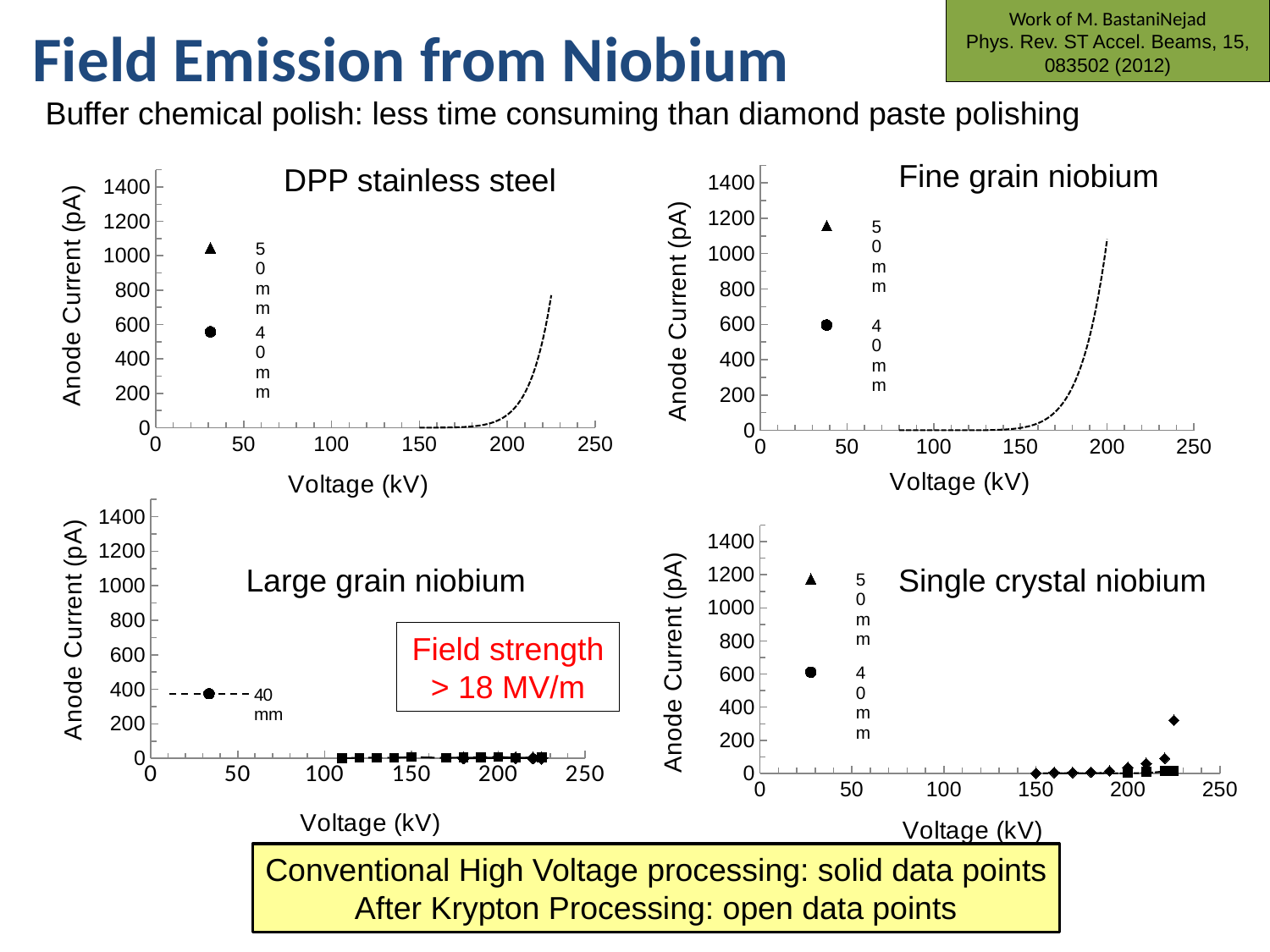
What is the y-axis label of the 'Fine grain niobium' chart? Anode Current (pA) In the 'DPP stainless steel' chart, how many series does the legend list? 2 What is the maximum value shown on the y-axis of the 'Single crystal niobium' chart? 1400 In the 'Single crystal niobium' chart, is the highest plotted anode current greater or less than 400 pA? less How many charts are shown on the slide? 4 In the 'Large grain niobium' chart, is the anode current at 200 kV greater or less than 200 pA? less What kind of chart is the 'DPP stainless steel' chart? scatter chart In the 'DPP stainless steel' chart, is the anode current at the highest plotted voltage greater or less than 600 pA? greater What is the x-axis label of the 'Single crystal niobium' chart? Voltage (kV) In the 'Large grain niobium' chart, how many series does the legend list? 1 In the 'DPP stainless steel' chart, does the anode current rise or fall as voltage increases above 150 kV? rise